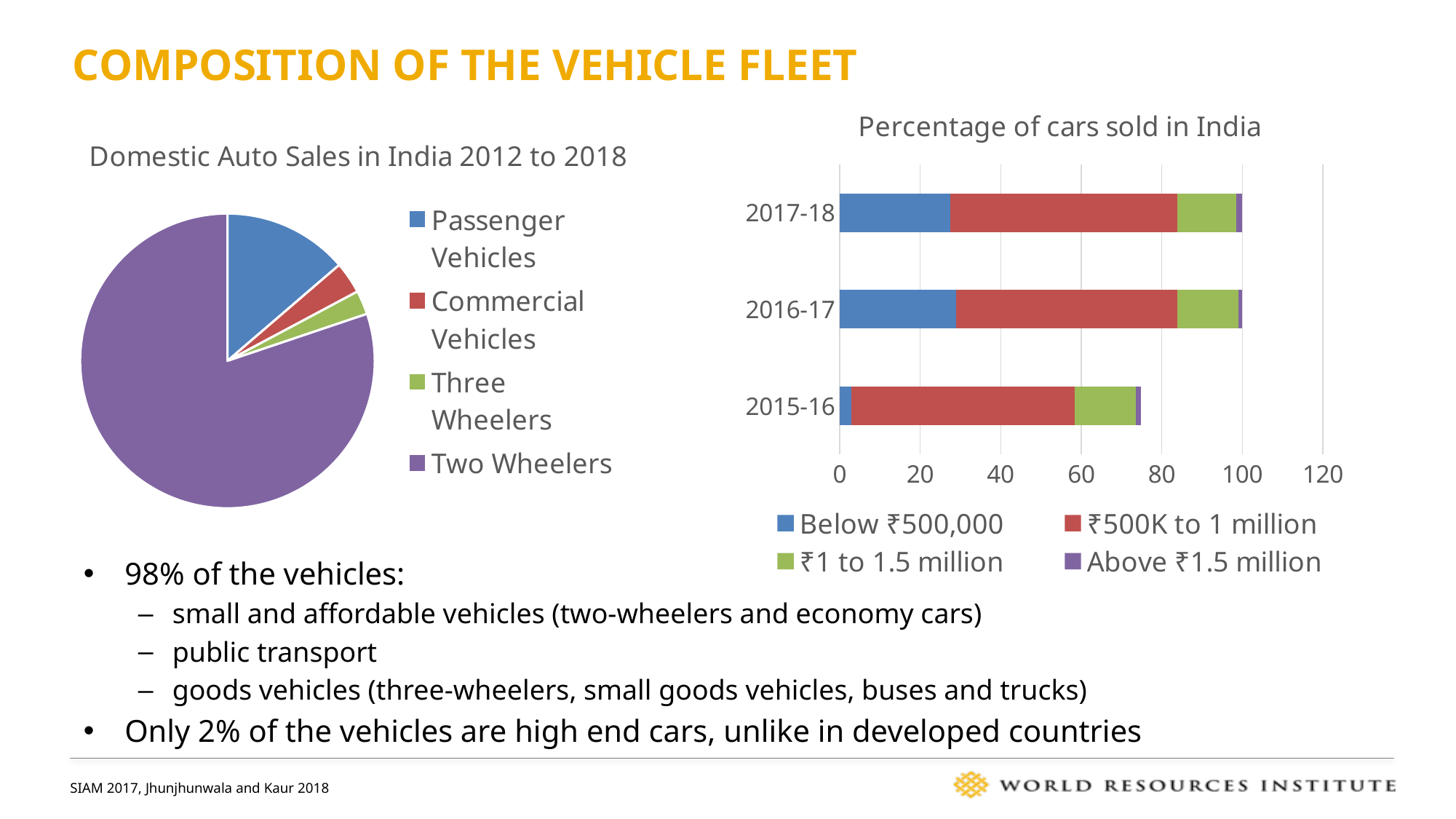
In the 'Percentage of cars sold in India' chart, how many years are shown on the vertical axis? 3 What kind of chart is the 'Domestic Auto Sales in India 2012 to 2018' chart? Pie chart In the 'Domestic Auto Sales in India 2012 to 2018' pie chart, which slice is larger: Passenger Vehicles or Commercial Vehicles? Passenger Vehicles In the 'Percentage of cars sold in India' chart, is the 'Below ₹500,000' segment for 2015-16 greater or less than 20? less In the 'Percentage of cars sold in India' chart, which price segment is the largest in the 2015-16 bar? ₹500K to 1 million In the 'Domestic Auto Sales in India 2012 to 2018' pie chart, which category has the largest slice? Two Wheelers In the 'Percentage of cars sold in India' chart, which year has the smallest 'Below ₹500,000' segment? 2015-16 In the 'Percentage of cars sold in India' chart, which series is shown in purple? Above ₹1.5 million In the 'Percentage of cars sold in India' chart, how many series does the legend list? 4 In the 'Domestic Auto Sales in India 2012 to 2018' pie chart, how many categories are shown? 4 What kind of chart is the 'Percentage of cars sold in India' chart? Stacked bar chart In the 'Percentage of cars sold in India' chart, is the total length of the 2015-16 bar greater or less than 80? less